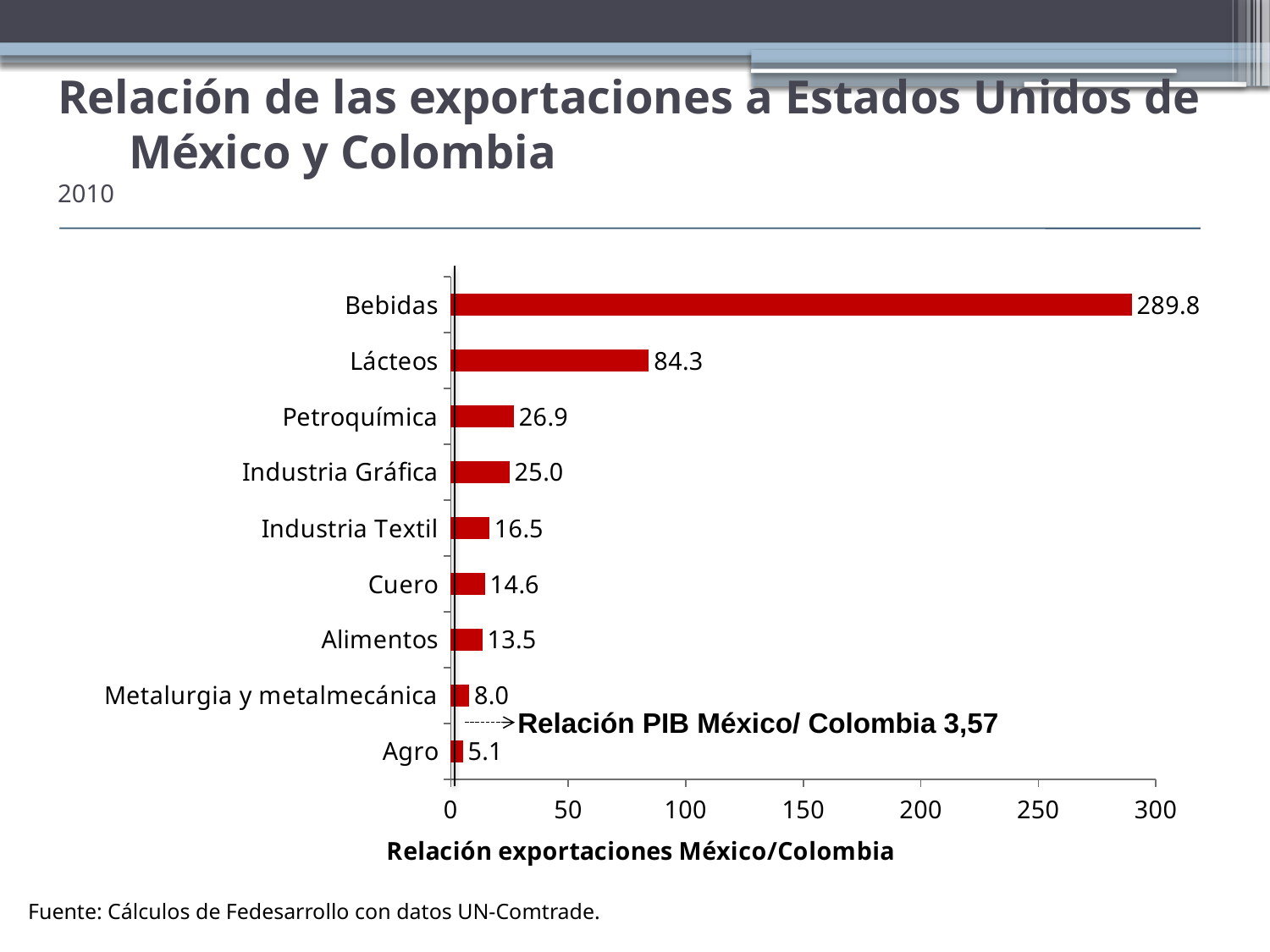
What is the x-axis title of the chart? Relación exportaciones México/Colombia What is the difference between the values for Petroquímica and Industria Gráfica? 1.9 Which category has the highest value? Bebidas What is the value for Bebidas? 289.8 Which category has the lowest value? Agro How many categories are shown in the chart? 9 What is the value for Lácteos? 84.3 What kind of chart is shown on the slide? Bar chart What is the value for Metalurgia y metalmecánica? 8.0 What is the value for Industria Textil? 16.5 Which is larger, the value for Cuero or the value for Alimentos? Cuero What is the difference between the values for Bebidas and Lácteos? 205.5